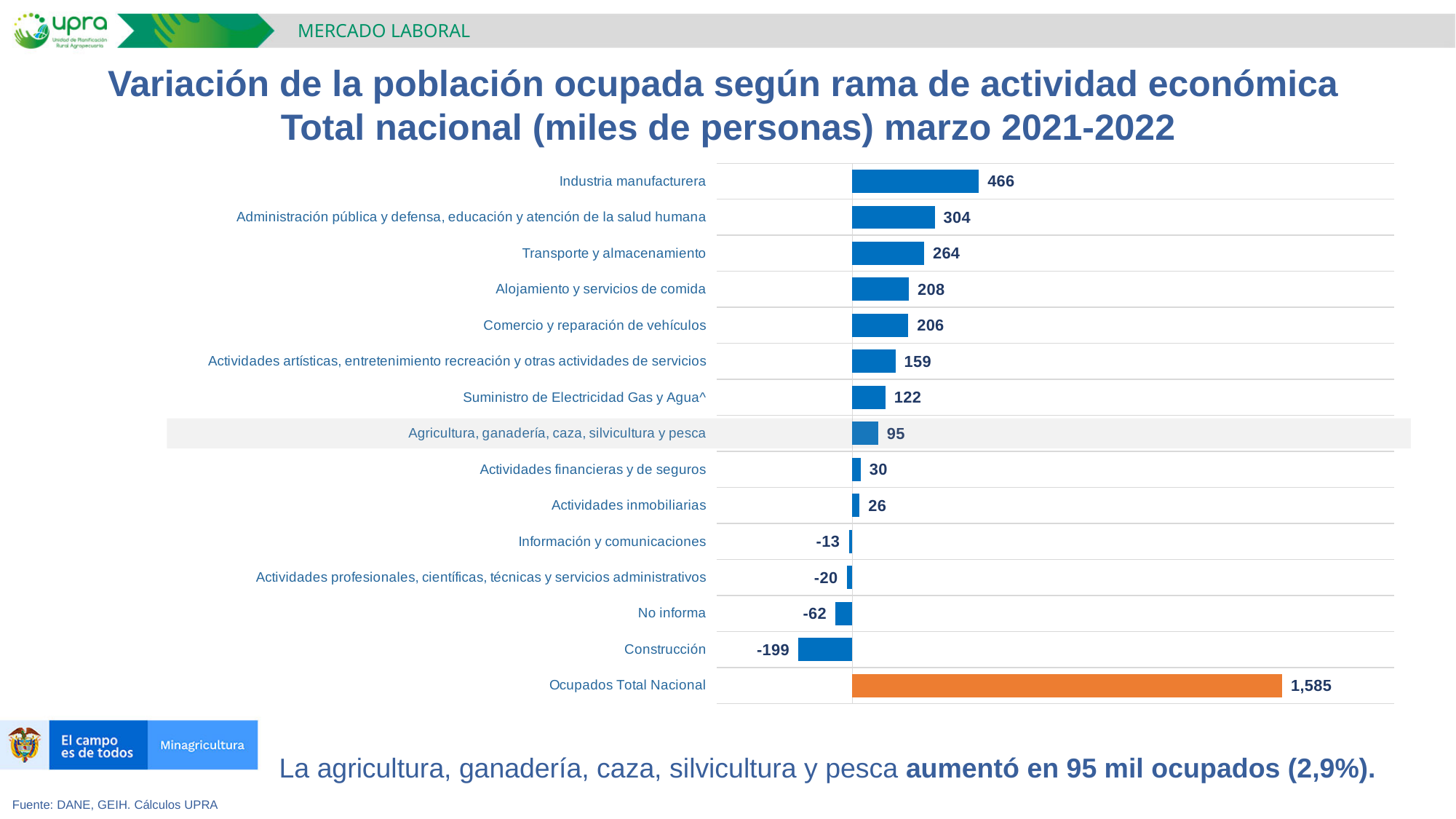
What colour is the bar for Ocupados Total Nacional? Orange What is the value for Agricultura, ganadería, caza, silvicultura y pesca? 95 What is the value for Ocupados Total Nacional? 1,585 Which is larger, the value for Transporte y almacenamiento or the value for Alojamiento y servicios de comida? Transporte y almacenamiento What kind of chart is shown on the slide? Bar chart What is the value for Industria manufacturera? 466 What is the value for Construcción? -199 What is the value for No informa? -62 Which category has the highest value? Ocupados Total Nacional Which category has the lowest value? Construcción What is the difference between the values for Industria manufacturera and Administración pública y defensa, educación y atención de la salud humana? 162 How many categories are shown in the chart? 15